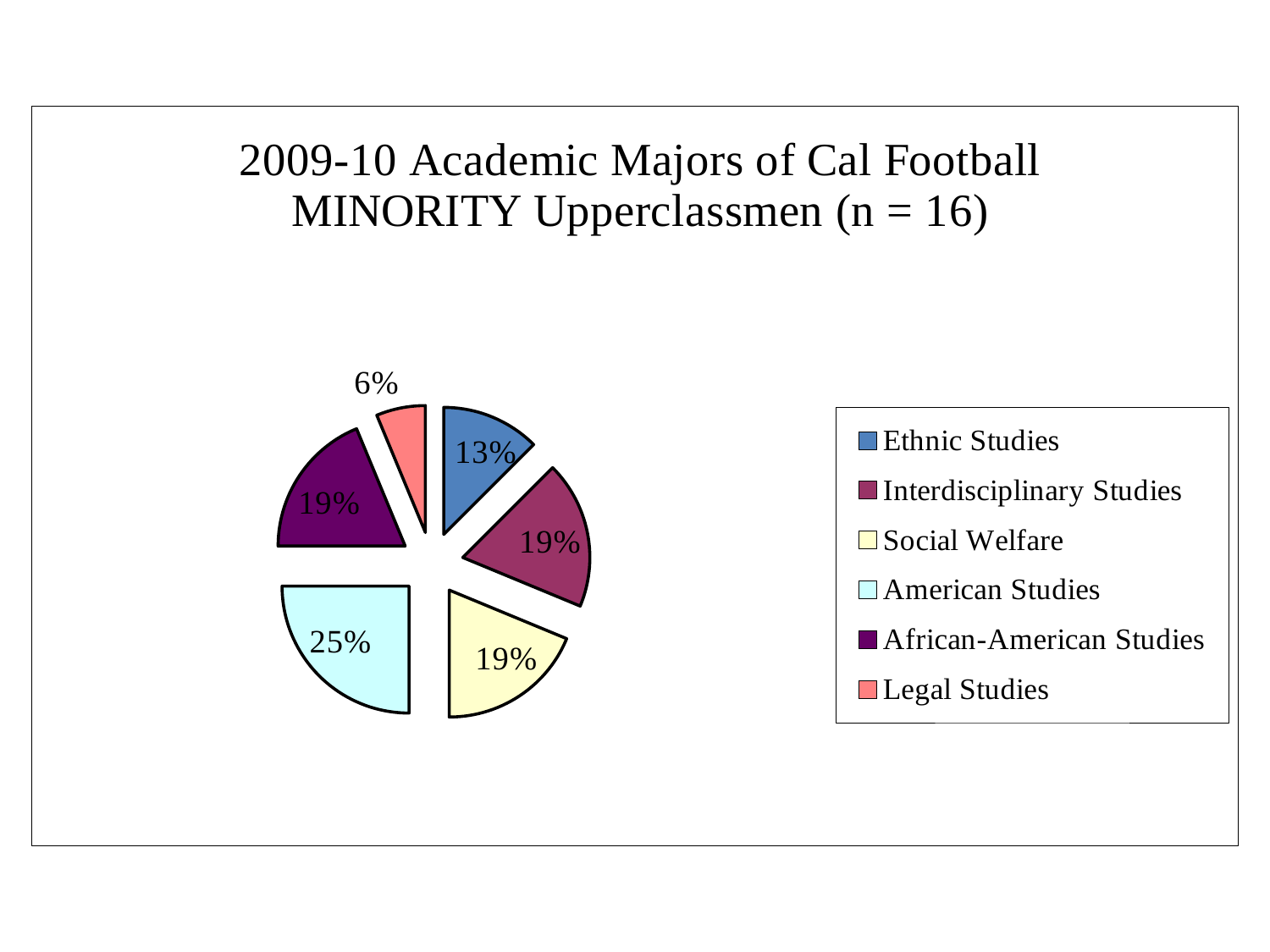
Which is larger, the slice for Ethnic Studies or the slice for Social Welfare? Social Welfare What share of the pie does Ethnic Studies represent? 13% What type of chart is shown on the slide? pie chart Which major has the largest slice of the pie? American Studies What share of the pie does Legal Studies represent? 6% What is the difference in percentage points between the American Studies slice and the Legal Studies slice? 19 How many majors (slices) are shown in the pie chart? 6 How many entries does the legend list? 6 What share of the pie does American Studies represent? 25% What is the title of the chart? 2009-10 Academic Majors of Cal Football MINORITY Upperclassmen (n = 16) Which major has the smallest slice of the pie? Legal Studies